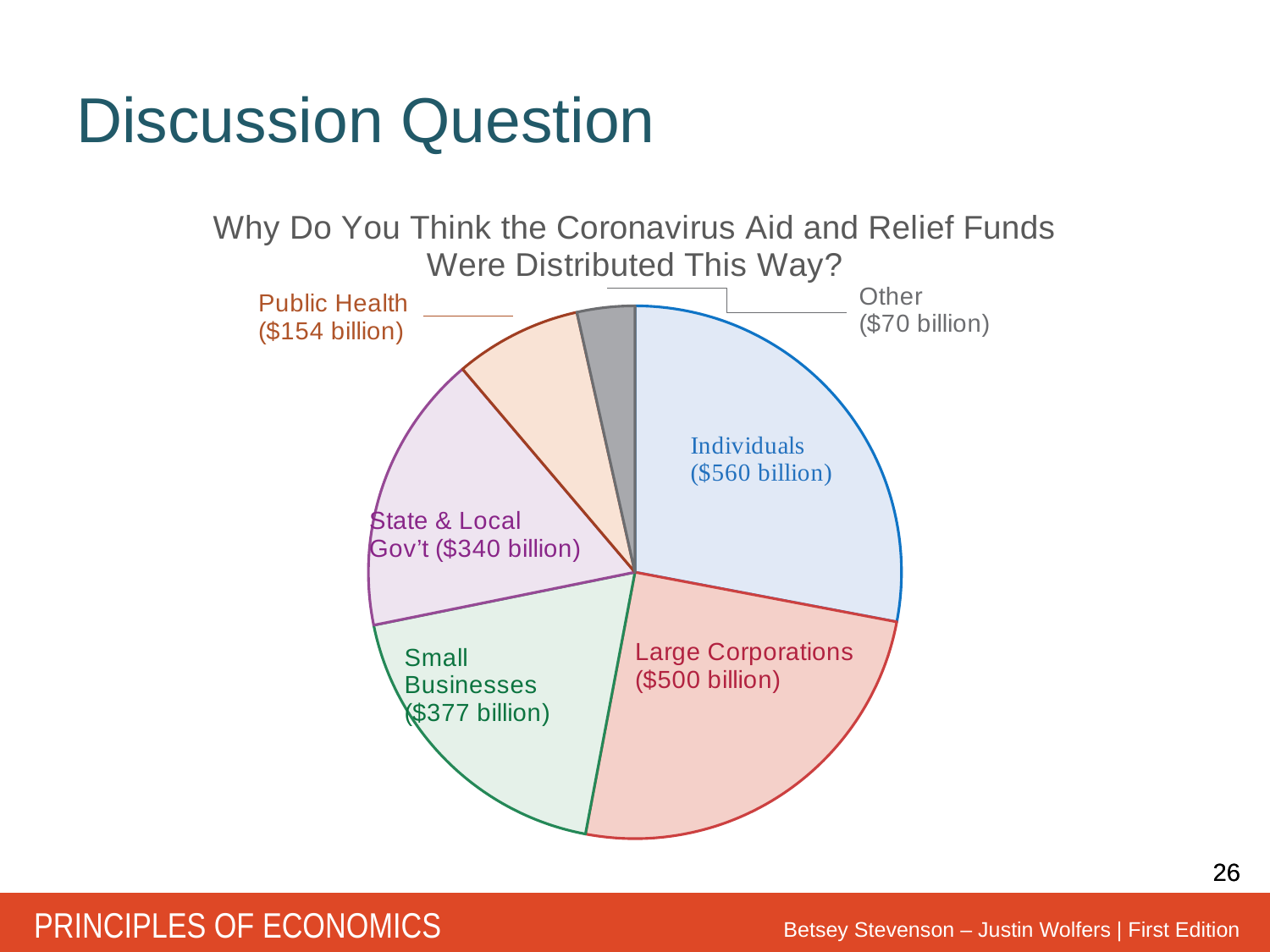
What is the difference between the Small Businesses and State & Local Gov't amounts? $37 billion How much aid went to Individuals according to the pie chart? $560 billion How many slices does the pie chart have? 6 What amount is shown for Public Health? $154 billion Which category received the smallest share of the funds? Other What amount is shown for Small Businesses? $377 billion What is the title of the pie chart? Why Do You Think the Coronavirus Aid and Relief Funds Were Distributed This Way? Which category received the largest share of the funds? Individuals What type of chart is shown on the slide? Pie chart How much more did Individuals receive than Large Corporations? $60 billion Which received more funds, Small Businesses or State & Local Gov't? Small Businesses What is the total of all the amounts shown in the pie chart? $2,001 billion